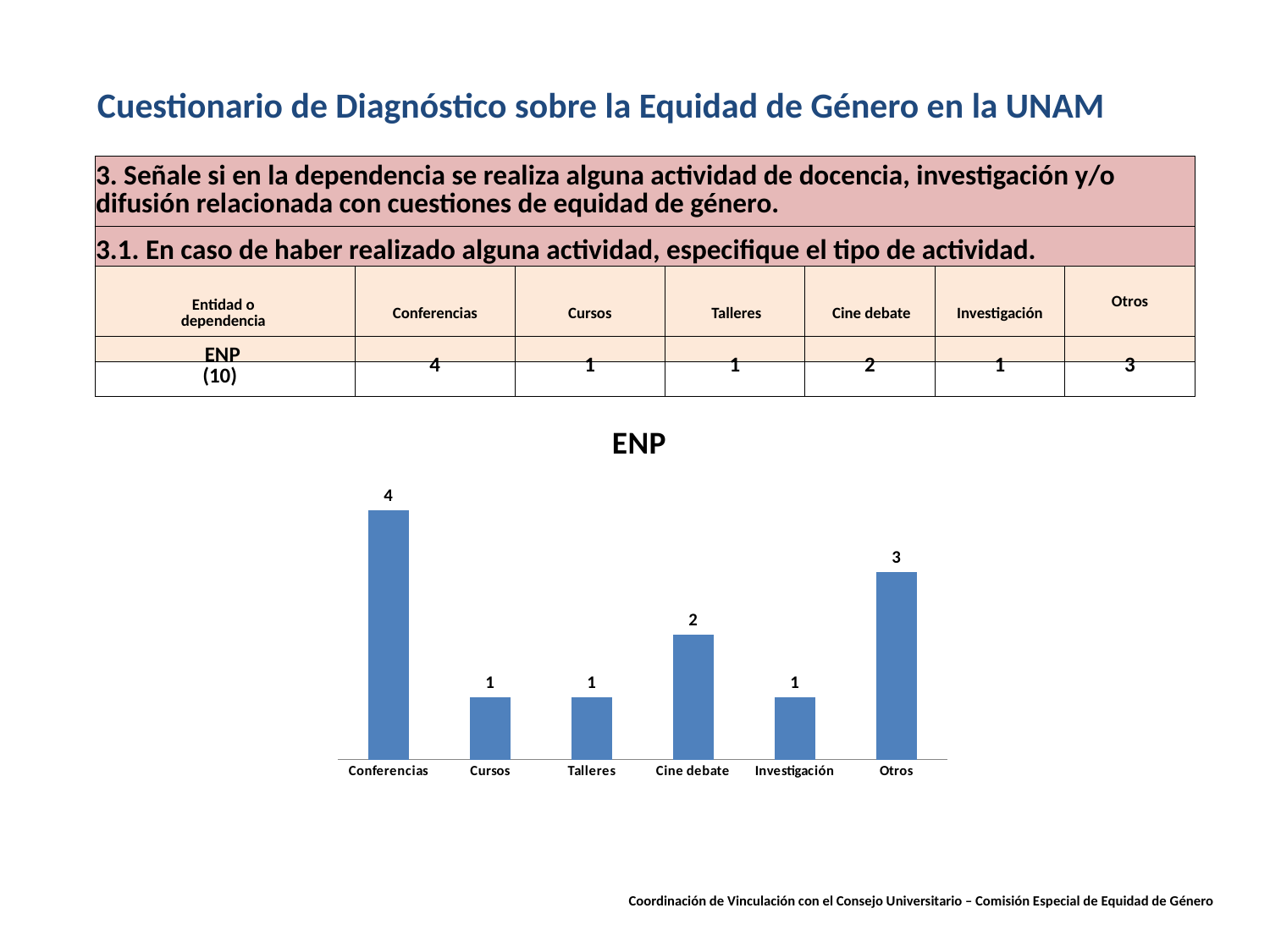
Which category has the highest value in the ENP chart? Conferencias What is the value for Otros in the ENP chart? 3 How many categories are shown in the ENP chart? 6 What kind of chart is the ENP chart? Bar chart Which is larger in the ENP chart, Conferencias or Investigación? Conferencias What is the difference between the values for Cine debate and Cursos in the ENP chart? 1 What is the value for Talleres in the ENP chart? 1 What is the title of the chart on the slide? ENP What is the value for Conferencias in the ENP chart? 4 What is the difference between the values for Conferencias and Otros in the ENP chart? 1 Which is larger in the ENP chart, Otros or Cine debate? Otros What is the value for Cine debate in the ENP chart? 2